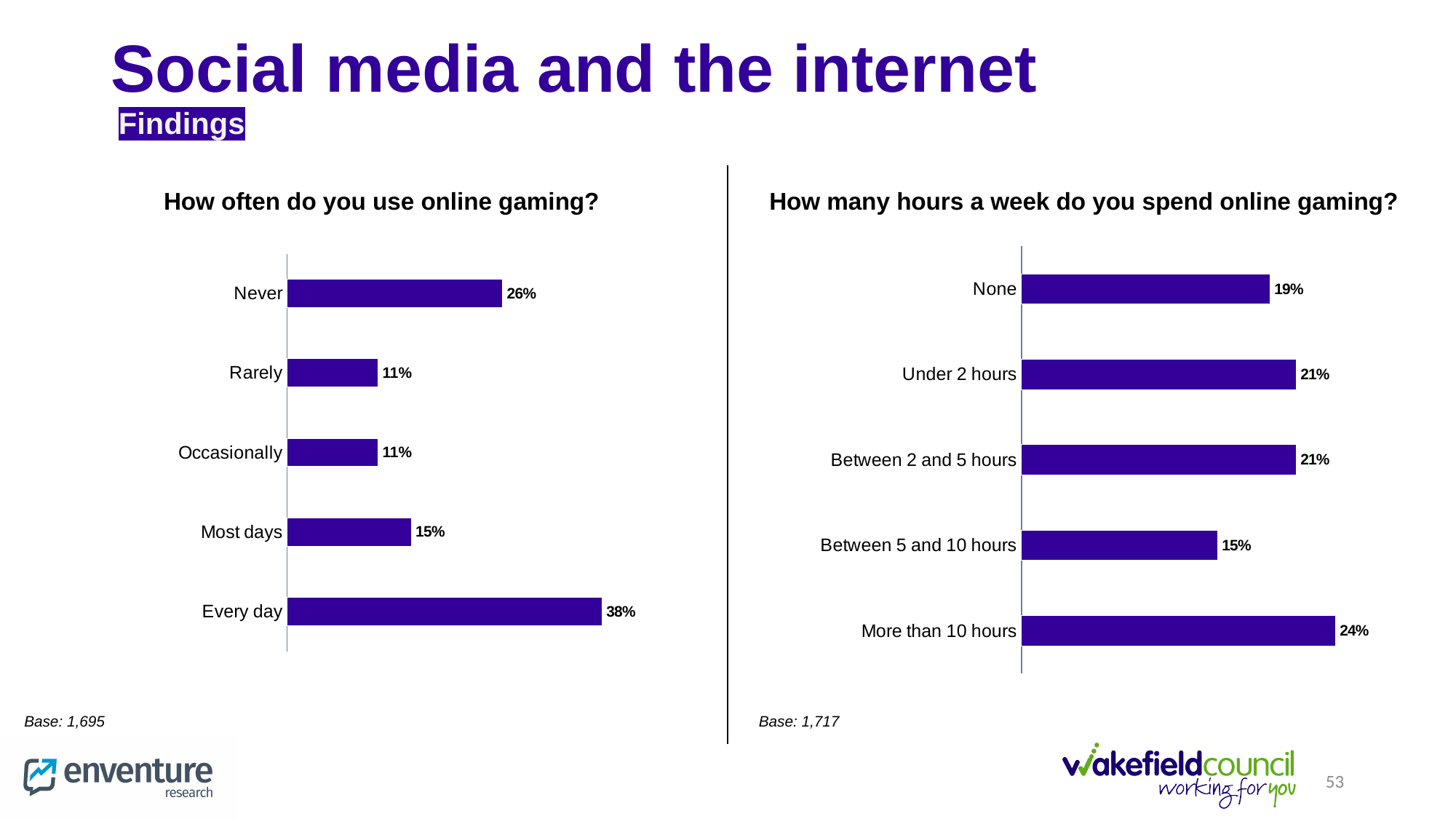
In the 'How often do you use online gaming?' chart, which category has the highest value? Every day In the 'How often do you use online gaming?' chart, what is the difference between 'Every day' and 'Never'? 12% In the 'How often do you use online gaming?' chart, what percentage of respondents said 'Never'? 26% In the 'How many hours a week do you spend online gaming?' chart, what is the difference between 'More than 10 hours' and 'Between 5 and 10 hours'? 9% In the 'How many hours a week do you spend online gaming?' chart, what percentage of respondents said 'None'? 19% In the 'How many hours a week do you spend online gaming?' chart, what percentage of respondents said 'More than 10 hours'? 24% In the 'How many hours a week do you spend online gaming?' chart, which is larger: 'None' or 'Under 2 hours'? Under 2 hours What is the base (number of respondents) shown for the 'How many hours a week do you spend online gaming?' chart? 1,717 In the 'How often do you use online gaming?' chart, what percentage of respondents said 'Every day'? 38% What type of chart is the 'How often do you use online gaming?' chart? Bar chart In the 'How many hours a week do you spend online gaming?' chart, which category has the lowest value? Between 5 and 10 hours In the 'How often do you use online gaming?' chart, how many categories are shown? 5